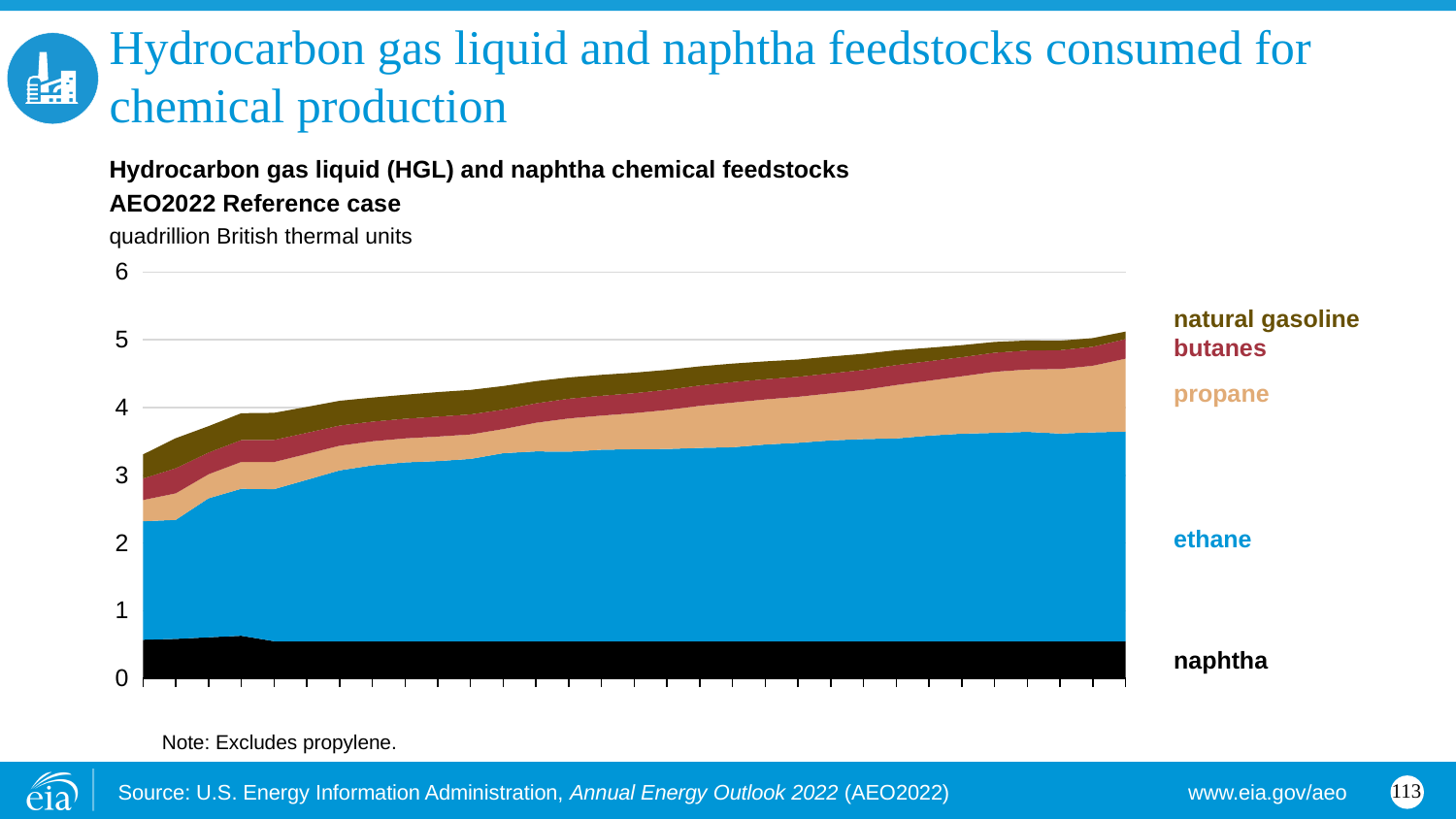
Is the total of all feedstocks at the right end of the chart greater or less than 4? greater What kind of chart is shown on the slide? stacked area chart Is the total of all feedstocks at the left end of the chart greater or less than 4? less Which series is plotted at the bottom of the stack? naphtha How many series (feedstock types) are labelled on the chart? 5 Which feedstock accounts for the largest share of the stacked total across the chart? ethane Which scenario does the chart show, according to its subtitle? AEO2022 Reference case Which is larger at the right end of the chart, the ethane band or the propane band? ethane What unit is the y axis measured in? quadrillion British thermal units Is the total of all feedstocks at the right end of the chart greater or less than 6? less Does the total of all feedstocks rise or fall from left to right along the x axis? rise